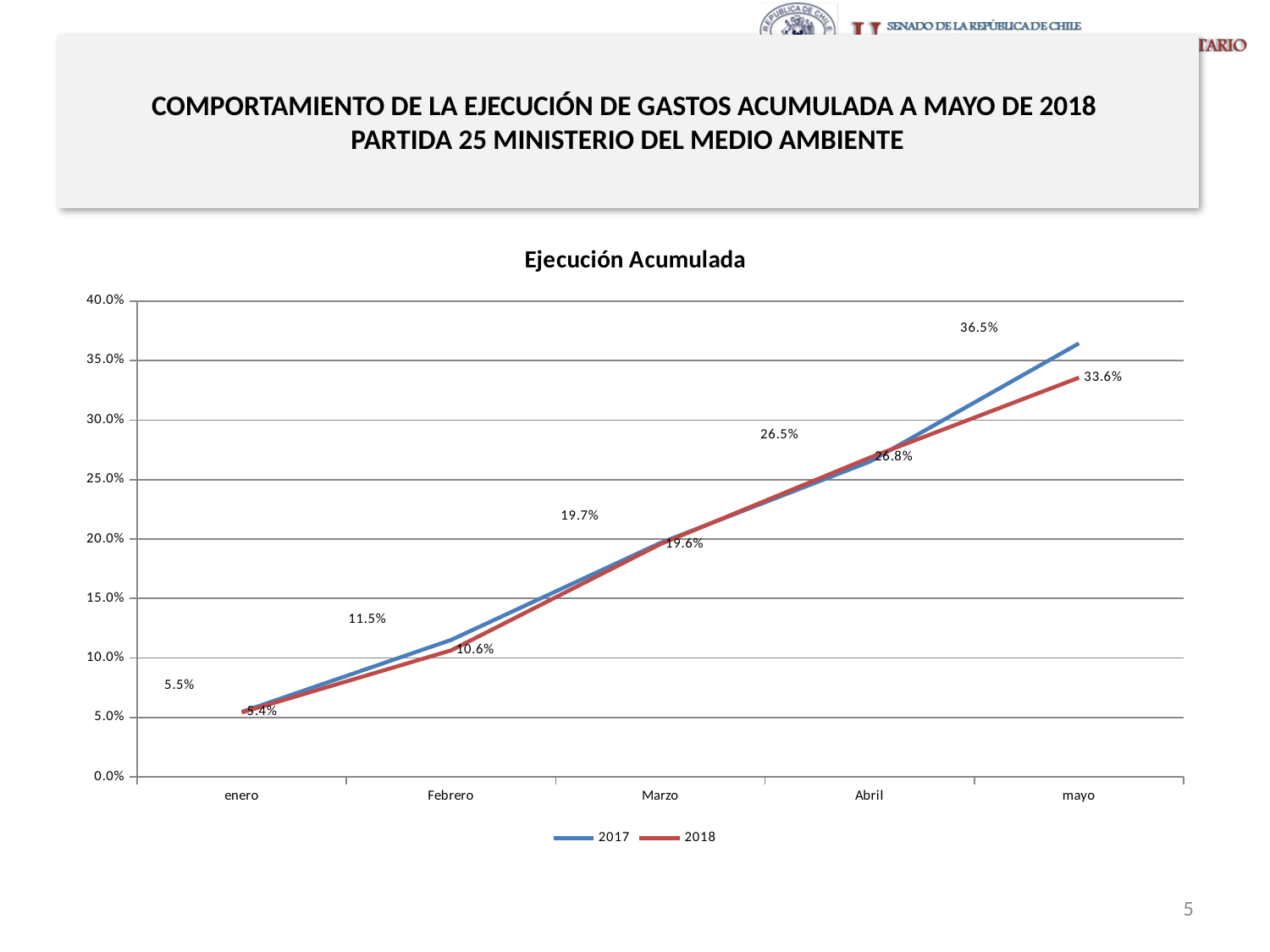
Which series has the larger value in mayo, 2017 or 2018? 2017 How many series does the legend list? 2 In which month is the 2017 series lowest? enero What is the title of the chart? Ejecución Acumulada How many months are shown on the x axis? 5 In which month is the 2018 series highest? mayo Do the values for 2018 rise or fall from enero to mayo? rise What is the value for 2018 in Abril? 26.8% What is the value for 2018 in Febrero? 10.6% What is the difference between the 2017 and 2018 values in mayo? 2.9% What is the value for 2017 in mayo? 36.5% What type of chart is shown on the slide? line chart